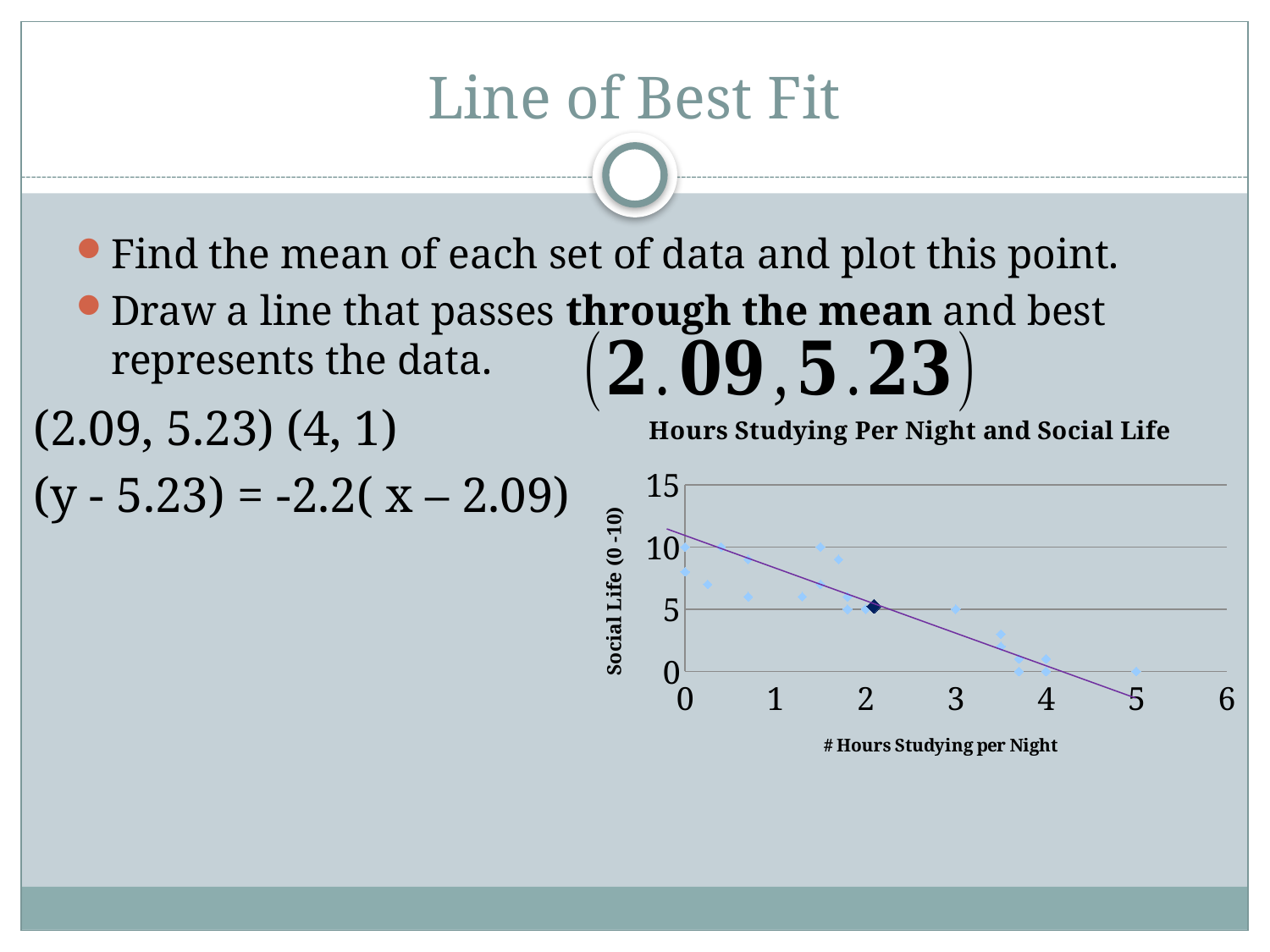
What kind of chart is shown on the slide? scatter chart As the number of hours studying per night increases, do the social life values rise or fall? fall Is the social life value for the point at 5 hours studying per night greater or less than 5? less What is the title of the chart? Hours Studying Per Night and Social Life What is the highest value shown on the x axis of the chart? 6 Is the social life value of the mean point greater or less than 5? greater What is the label on the x axis of the chart? # Hours Studying per Night What is the highest value shown on the y axis of the chart? 15 Is the social life value for the point at 3 hours studying per night greater or less than 10? less What are the coordinates of the mean point plotted on the chart? (2.09, 5.23) Does the line of best fit slope upward or downward from left to right? downward